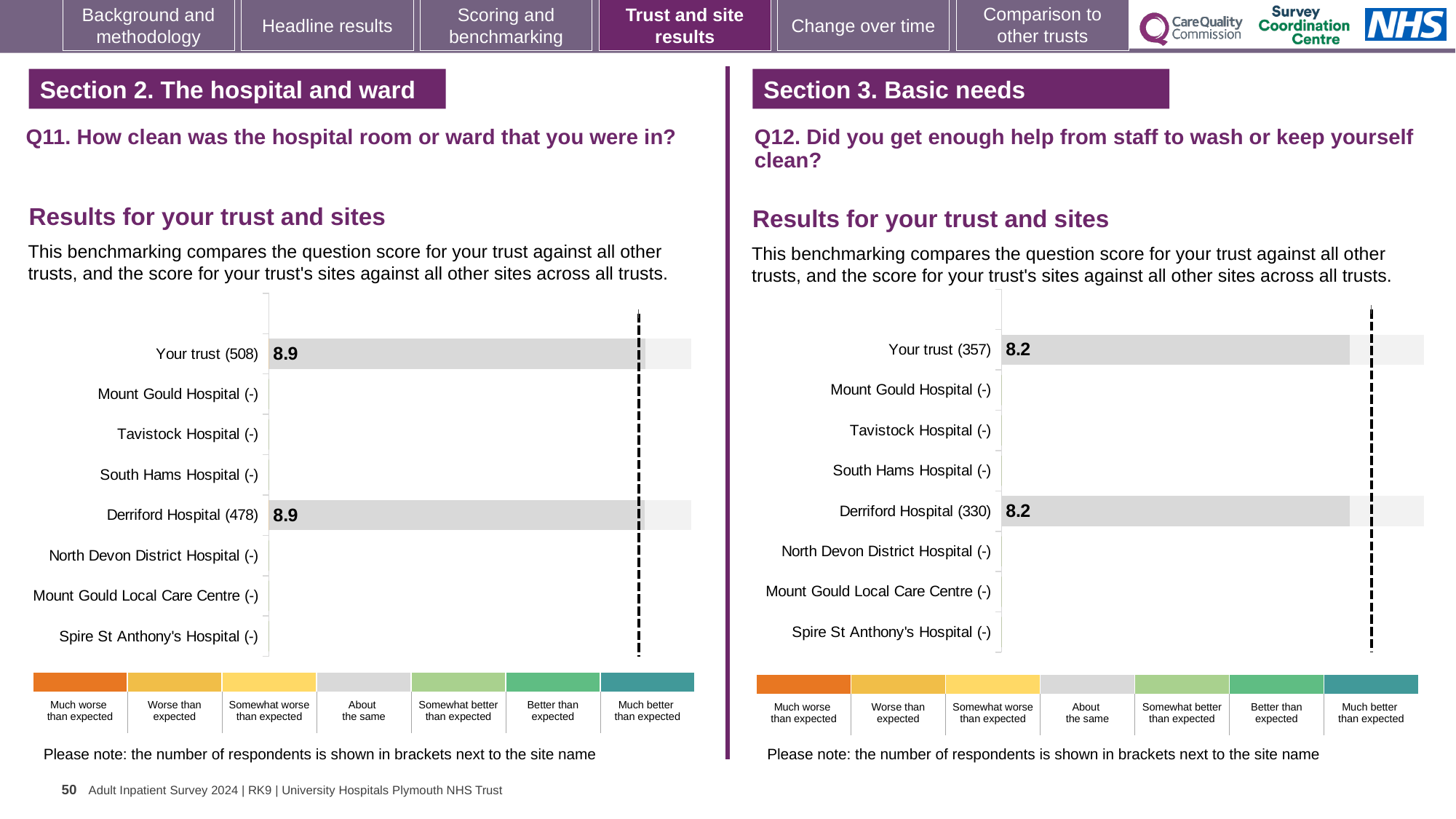
What kind of chart is the Q11 chart on the left? Bar chart On the Q11 chart (left), how many site or trust categories are listed on the vertical axis? 8 On the Q12 chart (right), what is the score for Your trust (357)? 8.2 On the Q12 chart (right), how many site or trust categories are listed on the vertical axis? 8 On the Q11 chart (left), what is the difference between the score for Your trust (508) and the score for Derriford Hospital (478)? 0 On the Q12 chart (right), how many respondents are shown in brackets for Derriford Hospital? 330 On the Q12 chart (right), what is the score for Derriford Hospital (330)? 8.2 On the Q12 chart (right), what is the difference between the score for Your trust (357) and the score for Derriford Hospital (330)? 0 On the Q11 chart (left), what is the label of the rightmost (teal) band in the colour key below the chart? Much better than expected On the Q11 chart (left), how many categories have a plotted bar with a score? 2 On the Q11 chart (left), what is the score for Your trust (508)? 8.9 On the Q11 chart (left), what is the score for Derriford Hospital (478)? 8.9